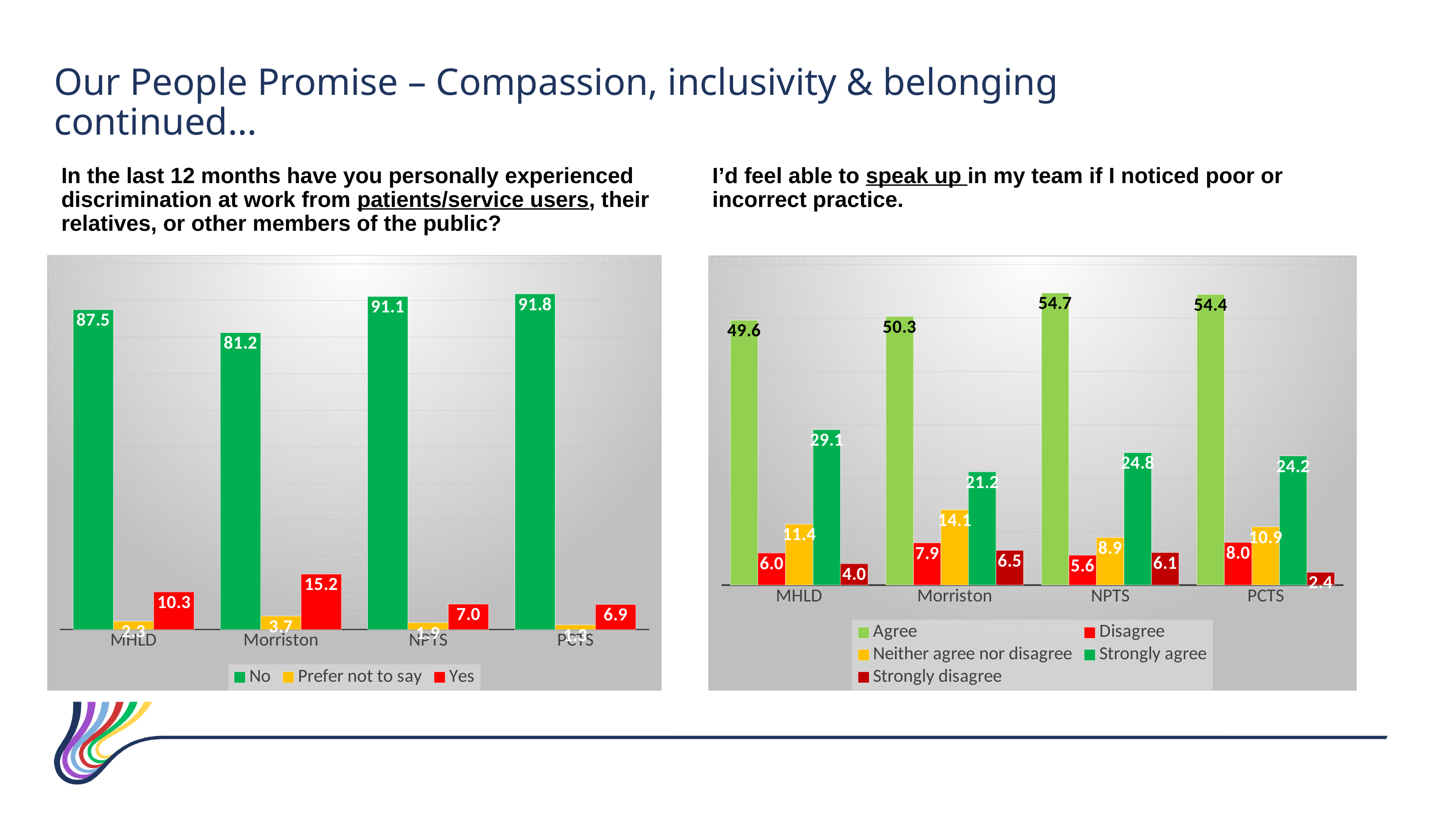
In the left chart (discrimination from patients/service users), what is the difference between the 'No' values for PCTS and MHLD? 4.3 In the right chart (speak up in my team), which category has the highest 'Agree' value? NPTS In the left chart (discrimination from patients/service users), what is the value for 'Yes' at Morriston? 15.2 In the left chart (discrimination from patients/service users), which category has the highest 'Yes' value? Morriston In the right chart (speak up in my team), what is the 'Neither agree nor disagree' value for Morriston? 14.1 In the left chart (discrimination from patients/service users), which category has the lowest 'No' value? Morriston In the right chart (speak up in my team), what is the 'Strongly agree' value for MHLD? 29.1 In the right chart (speak up in my team), which category has the lowest 'Strongly disagree' value? PCTS In the left chart (discrimination from patients/service users), how many series does the legend list? 3 In the right chart (speak up in my team), is the 'Disagree' value larger for Morriston or for NPTS? Morriston In the right chart (speak up in my team), how many series does the legend list? 5 In the left chart (discrimination from patients/service users), what is the value for 'No' at NPTS? 91.1